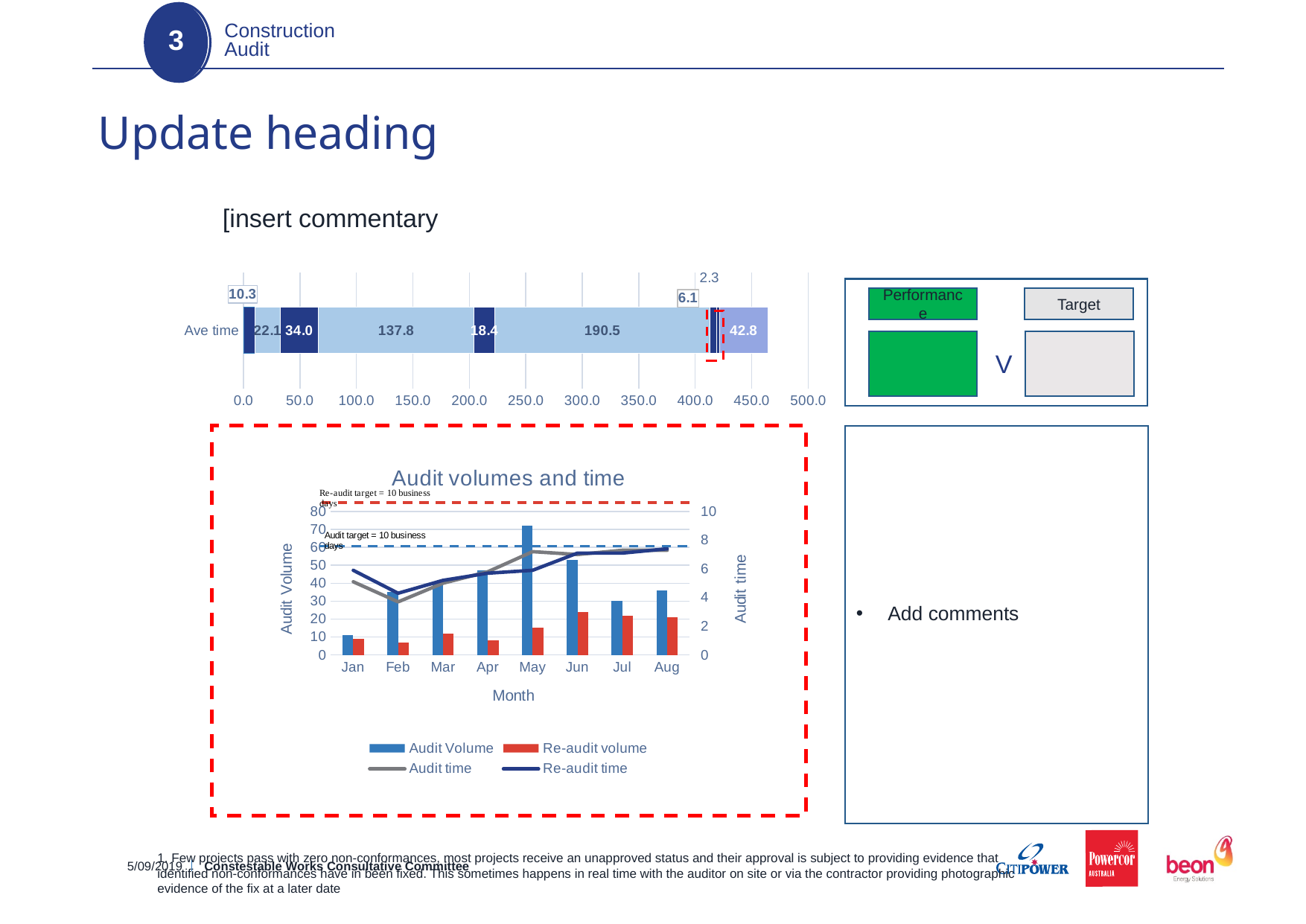
In the 'Audit volumes and time' chart, is the Audit Volume for May greater or less than 60? greater In the top 'Ave time' stacked bar chart, what is the value of the last (rightmost) segment? 42.8 In the 'Audit volumes and time' chart, which month has the lowest Audit Volume? Jan In the top 'Ave time' stacked bar chart, what is the value of the smallest labelled segment? 2.3 In the 'Audit volumes and time' chart, which is larger in Mar: Audit Volume or Re-audit volume? Audit Volume In the 'Audit volumes and time' chart, is the Re-audit volume for Feb greater or less than 10? less In the 'Audit volumes and time' chart, how many series does the legend list? 4 In the 'Audit volumes and time' chart, how many months are shown on the x axis? 8 In the top 'Ave time' stacked bar chart, what is the highest value shown on the horizontal axis? 500.0 In the top 'Ave time' stacked bar chart, what is the difference between the 190.5 segment and the 137.8 segment? 52.7 In the 'Audit volumes and time' chart, which month has the highest Audit Volume? May In the top 'Ave time' stacked bar chart, what is the value of the largest segment? 190.5